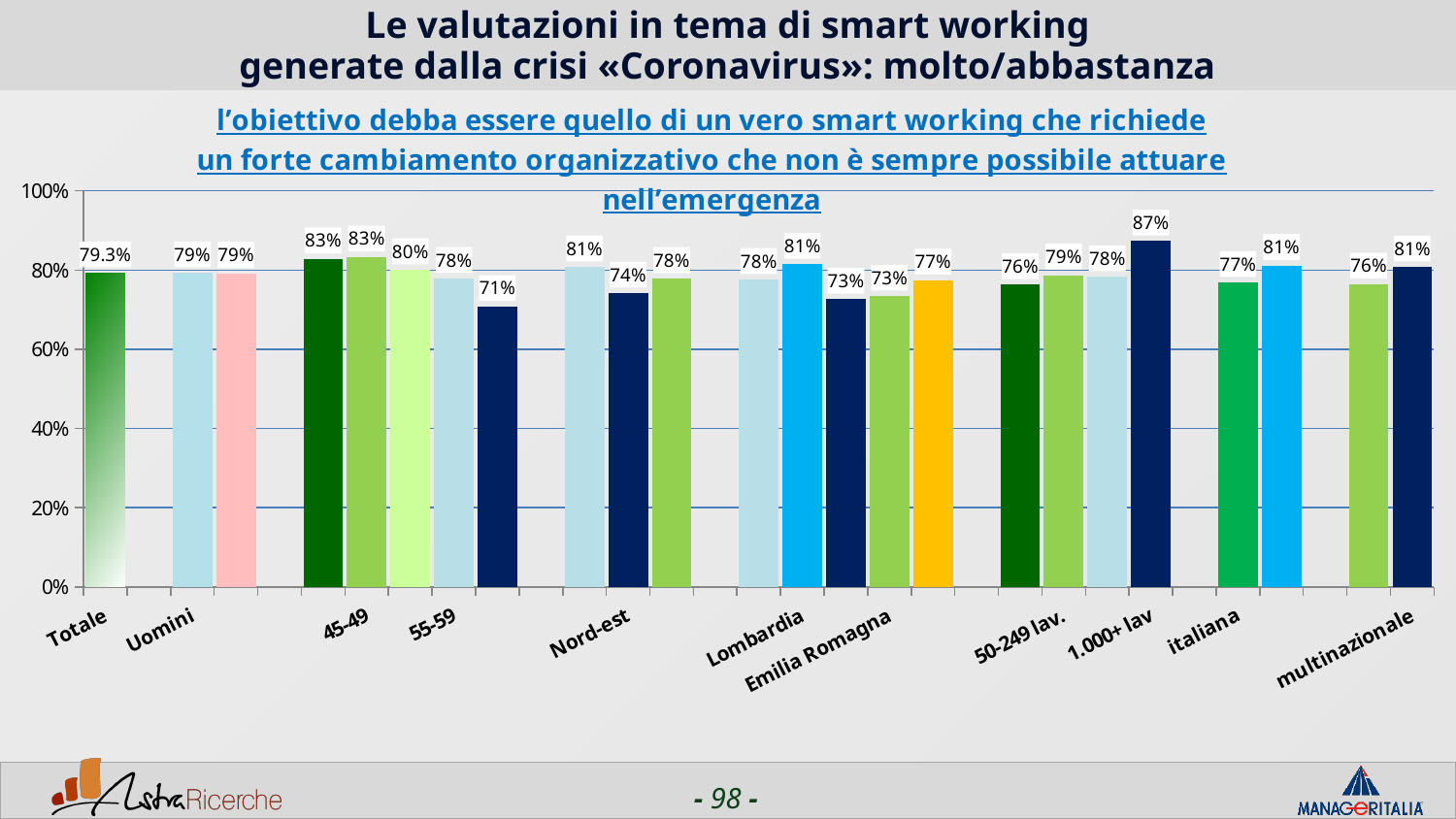
Is the value for Emilia Romagna greater or less than 60%? greater What is the value for the 45-49 age group? 83% What is the value for 1.000+ lav? 87% Which is larger, the value for 45-49 or the value for Emilia Romagna? 45-49 What is the lowest value shown on the chart? 71% What is the difference between the value for 45-49 and the value for Totale? 3.7 percentage points What is the value for Totale? 79.3% What is the value for Uomini? 79% What is the value for Emilia Romagna? 73% What is the highest value shown on the chart? 87% How many bars are plotted on the chart? 24 What kind of chart is shown on the slide? Bar chart